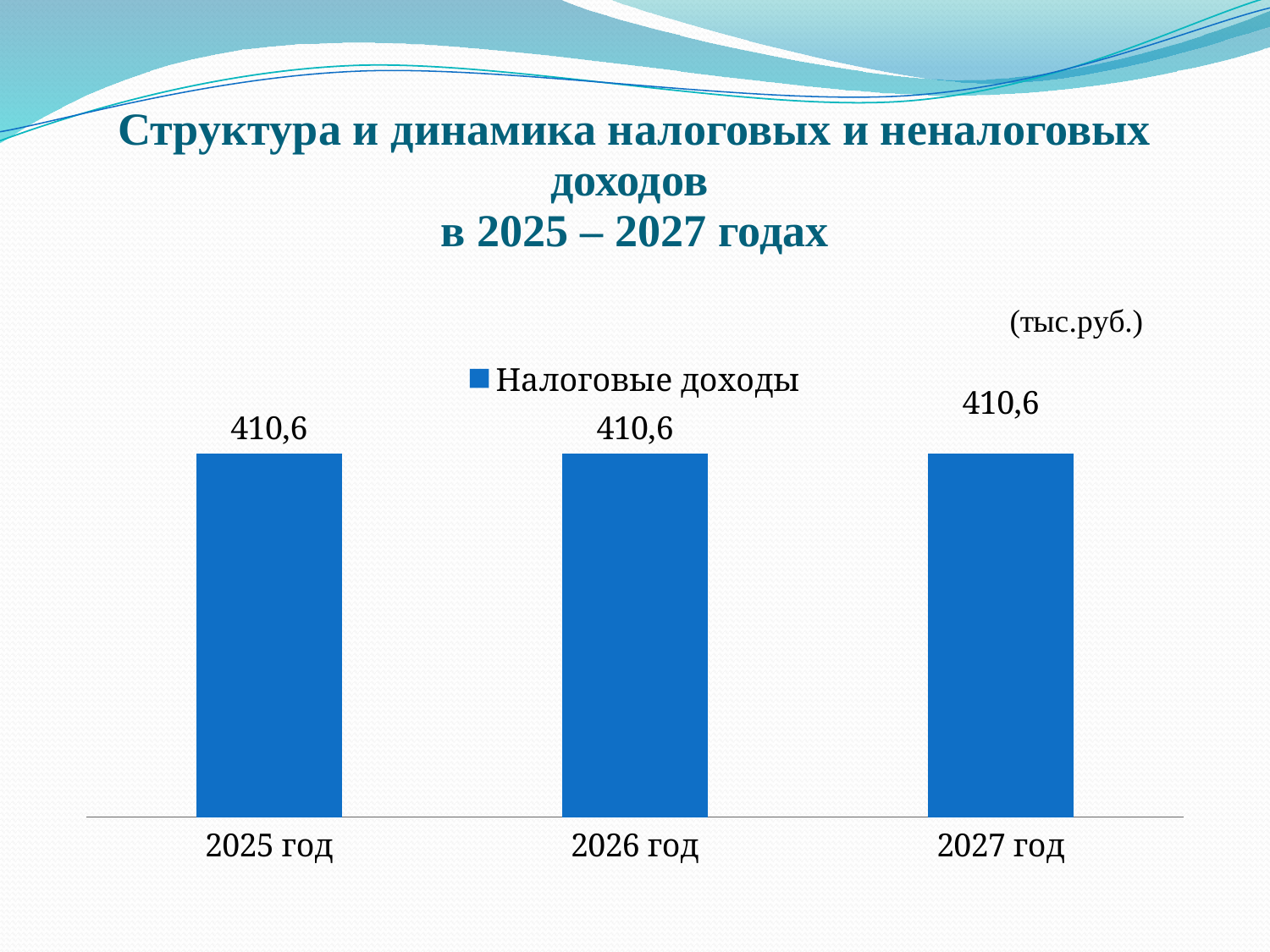
What is the value for 2027 год? 410,6 How many series does the legend list? 1 What series name is shown in the legend? Налоговые доходы Do the values rise, fall or stay the same from 2025 год to 2027 год? stay the same What is the value for 2026 год? 410,6 What is the value for 2025 год? 410,6 What kind of chart is shown on the slide? bar chart How many categories are shown on the x axis? 3 What is the difference between the values for 2025 год and 2027 год? 0 What unit is indicated above the chart? тыс.руб.